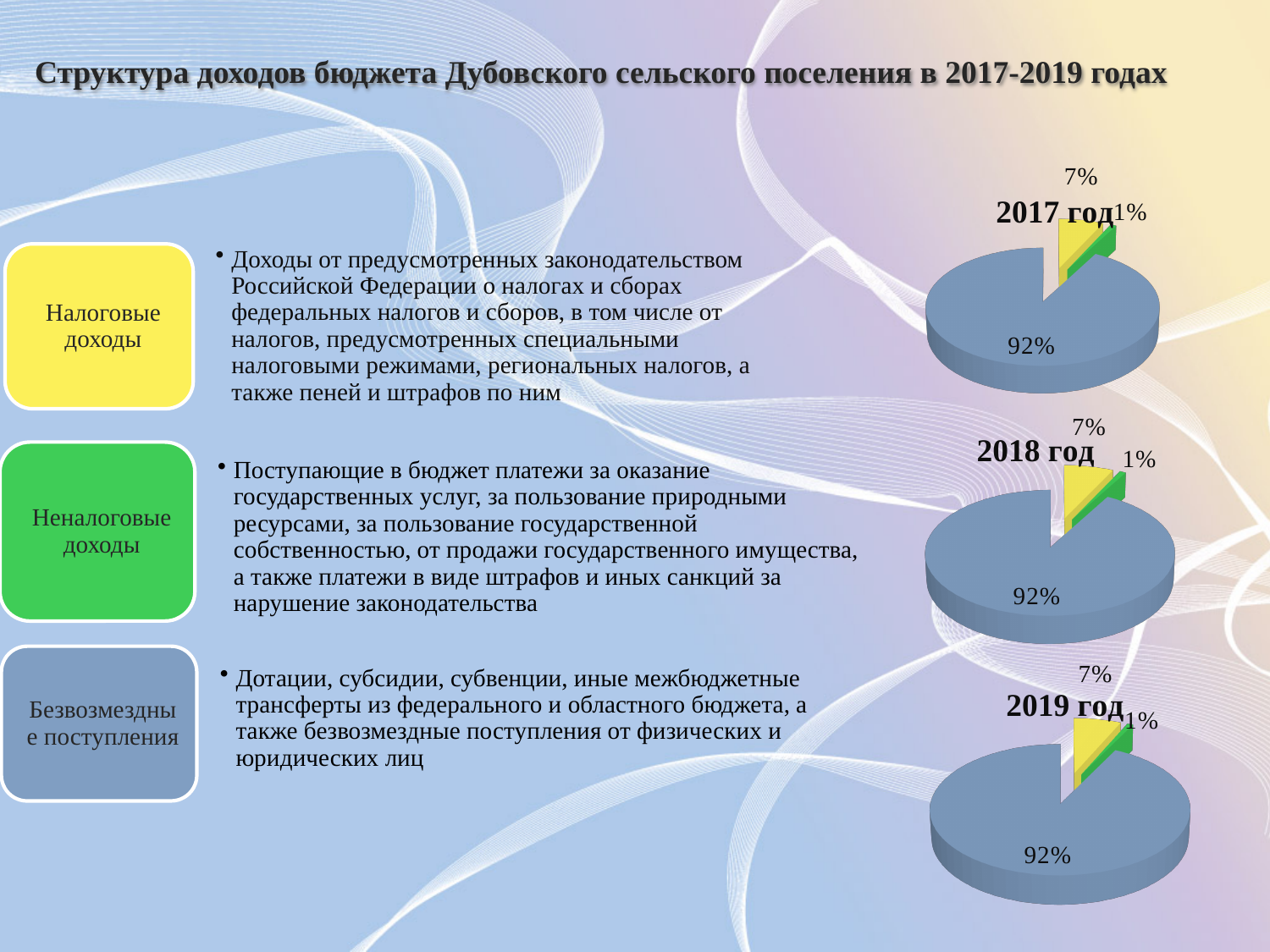
In the 2019 год pie chart, what is the value of the smallest slice? 1% In the 2018 год pie chart, what is the value of the yellow slice? 7% In the 2017 год pie chart, what is the difference between the largest slice and the yellow slice? 85% What kind of chart is used to show the 2017 год data? pie chart In the 2018 год pie chart, which is larger: the yellow slice or the green slice? the yellow slice In the 2019 год pie chart, what is the difference between the 7% slice and the 1% slice? 6% In the 2017 год pie chart, what is the value of the largest slice? 92% Does the share of the largest slice change between the 2017 год and 2019 год pie charts? No, it is 92% in both How many pie charts are shown on the slide? 3 In the 2019 год pie chart, what is the value of the blue slice? 92% Which colour is used for the largest slice in all three pie charts? blue How many slices does the 2018 год pie chart have? 3